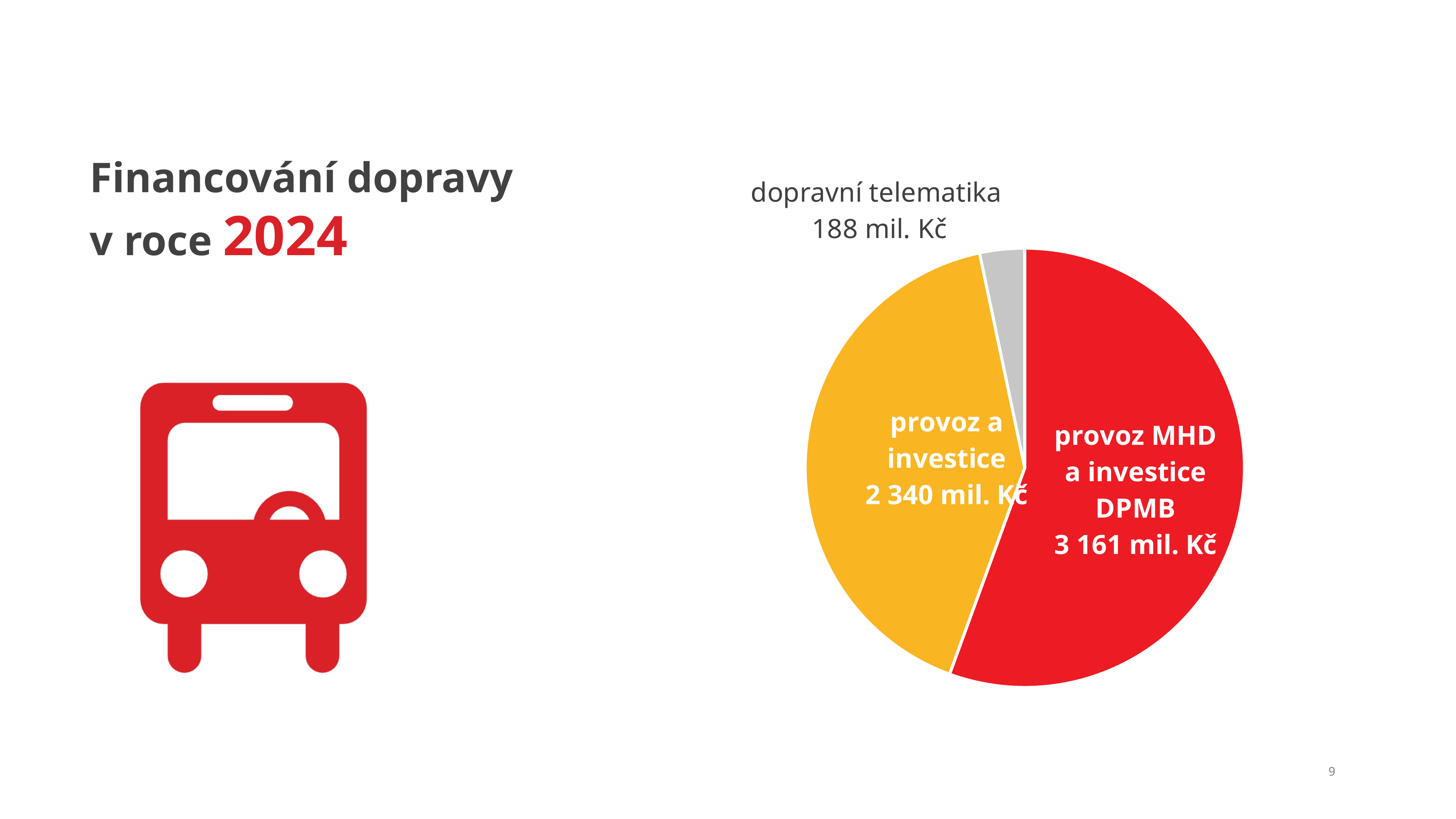
How many slices does the pie chart have? 3 Which is larger, "provoz a investice" or "dopravní telematika"? provoz a investice Which category has the smallest slice of the pie? dopravní telematika What is the value for "provoz a investice"? 2 340 mil. Kč What is the difference between "provoz a investice" and "dopravní telematika"? 2 152 mil. Kč What is the value for "provoz MHD a investice DPMB"? 3 161 mil. Kč What kind of chart is shown on the slide? pie chart Which category has the largest slice of the pie? provoz MHD a investice DPMB What colour is the "dopravní telematika" slice? grey What is the value for "dopravní telematika"? 188 mil. Kč What is the total of all three slices in the pie chart? 5 689 mil. Kč What is the difference between "provoz MHD a investice DPMB" and "provoz a investice"? 821 mil. Kč